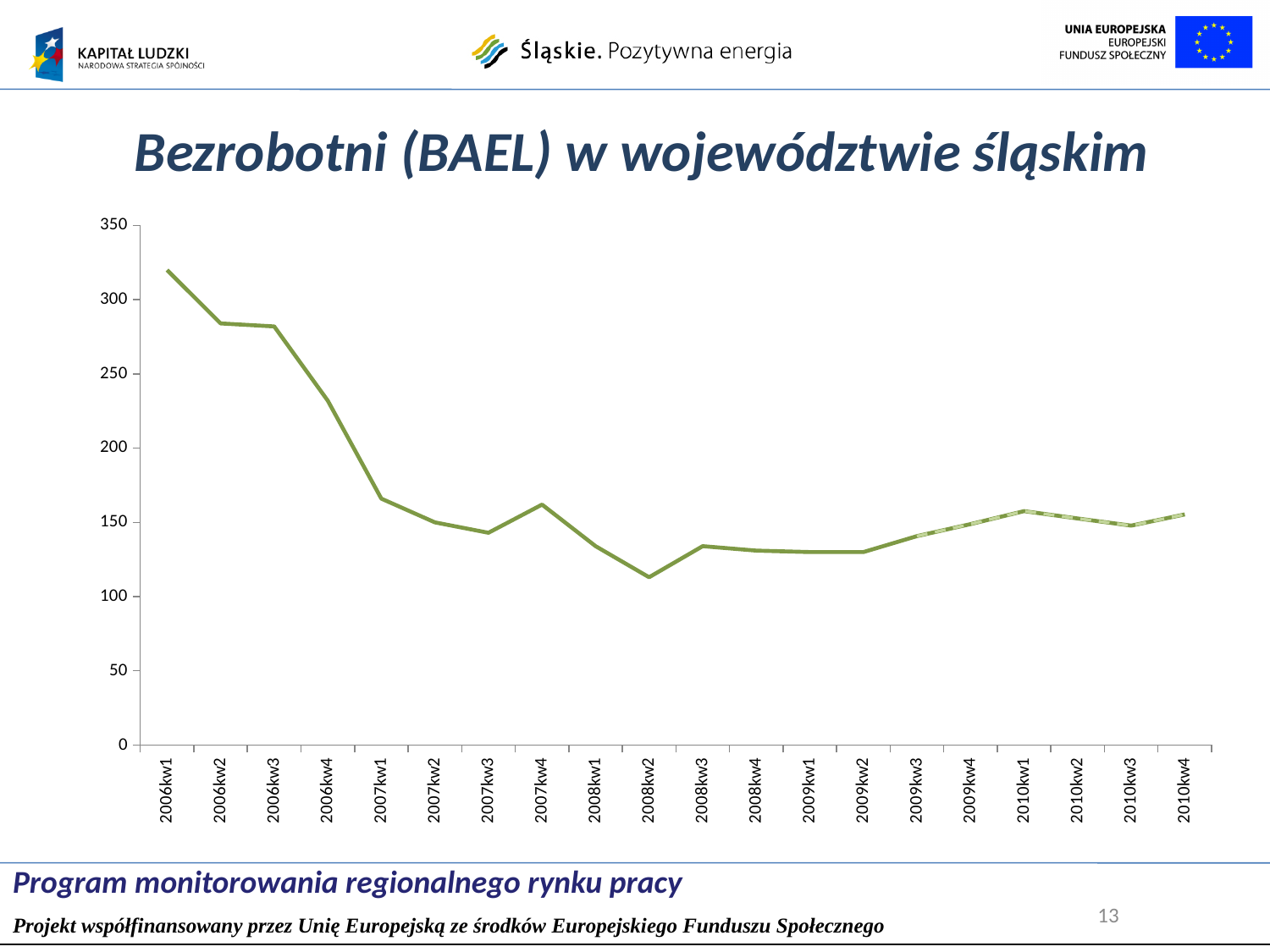
Do the values rise or fall from 2006kw1 to 2007kw1? fall What kind of chart is shown on the slide? line chart How many quarters (data points) are plotted along the x axis? 20 Which quarter has the lowest value? 2008kw2 Is the value for 2006kw1 greater or less than 300? greater Is the value for 2006kw4 greater or less than 250? less Is the value for 2009kw1 greater or less than 150? less Which is larger, the value for 2006kw2 or the value for 2007kw1? 2006kw2 Which is larger, the value for 2007kw4 or the value for 2008kw1? 2007kw4 Which quarter has the highest value? 2006kw1 What is the title of the chart? Bezrobotni (BAEL) w województwie śląskim